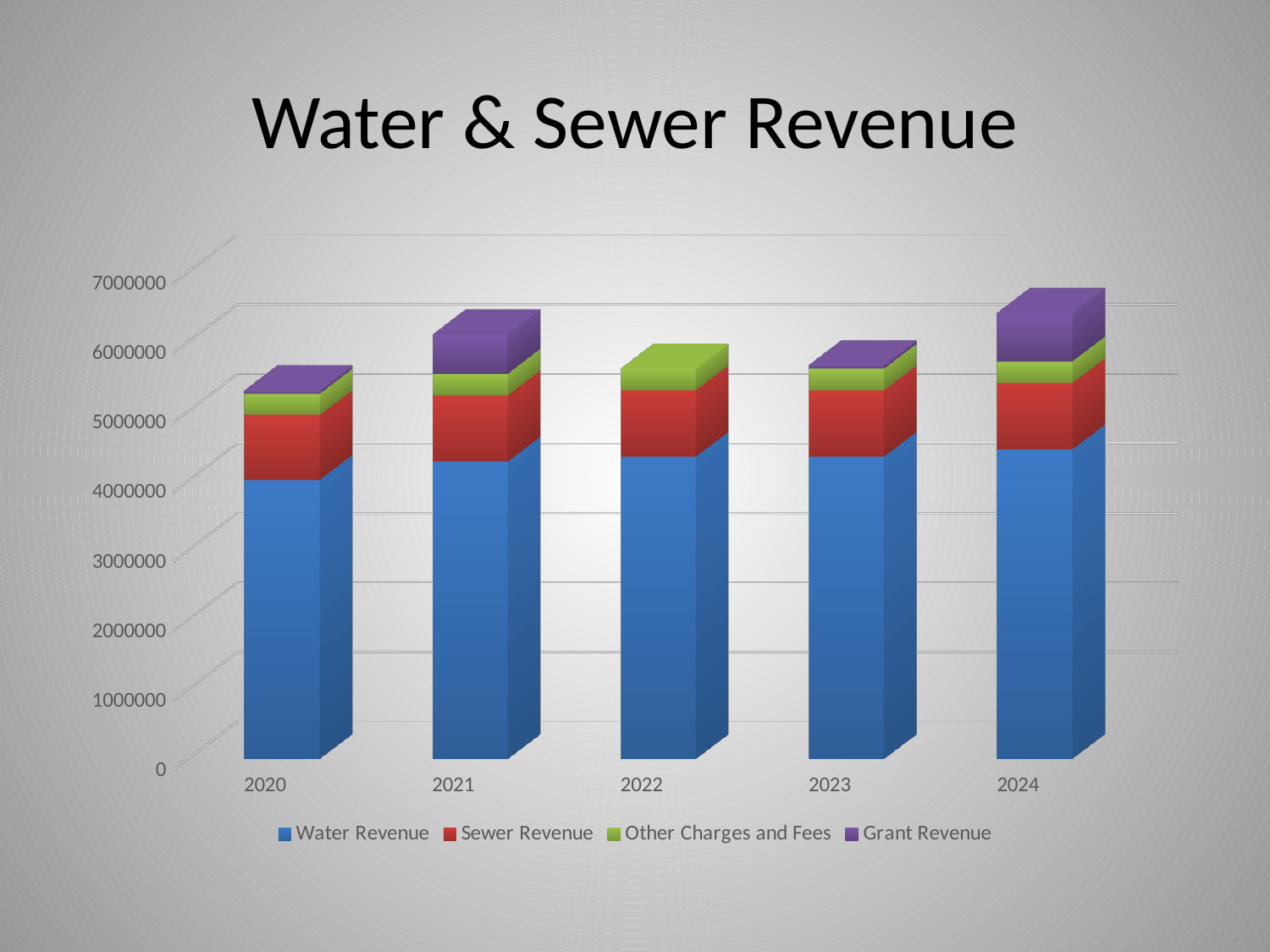
Which year has the lowest total stacked bar? 2020 Which year has the highest total stacked bar? 2024 Is the total stacked bar for 2024 greater or less than 6000000? greater How many years are shown on the x axis of the chart? 5 What is the title of the chart? Water & Sewer Revenue Is the Water Revenue value for 2024 greater or less than 4000000? greater How many series does the legend list? 4 Is the total stacked bar for 2020 greater or less than 6000000? less What kind of chart is shown on the slide? Stacked bar chart Which series is shown in purple in the legend? Grant Revenue Which total stacked bar is larger, 2020 or 2024? 2024